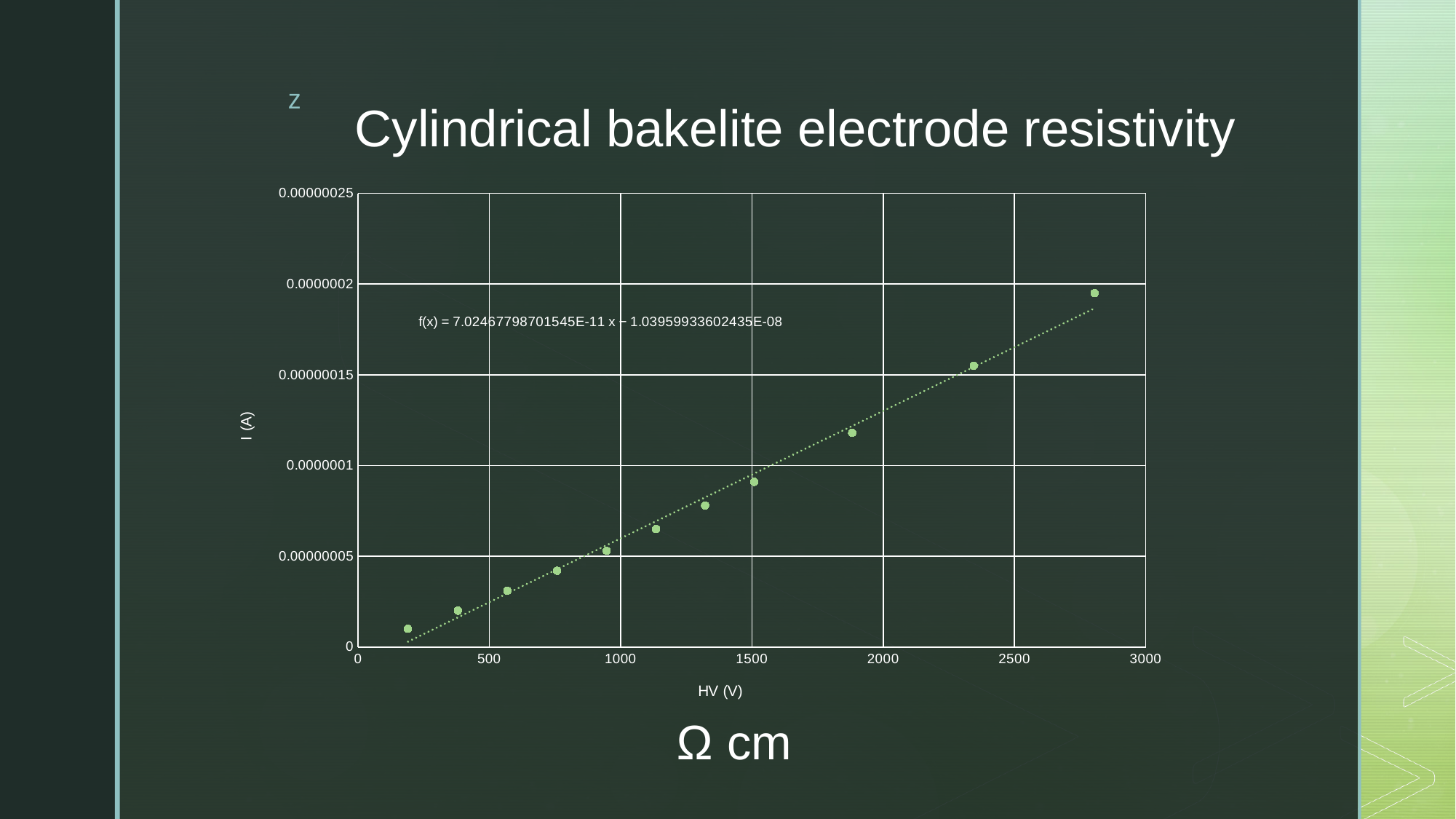
What is the maximum value shown on the x axis? 3000 Is the current value for the data point at the highest HV (around 2800 V) greater or less than 0.00000015? greater How many data points are plotted on the chart? 11 What is the title of the chart? Cylindrical bakelite electrode resistivity Which data point has the highest current value: the one at the lowest HV or the one at the highest HV? The one at the highest HV What is the label of the x axis? HV (V) Is the current value for the data point near 1500 V greater or less than 0.0000001? less Do the plotted current values rise or fall as HV increases along the x axis? Rise Is the current value for the data point at the highest HV (around 2800 V) greater or less than 0.0000002? less What kind of chart is shown on the slide? Scatter chart